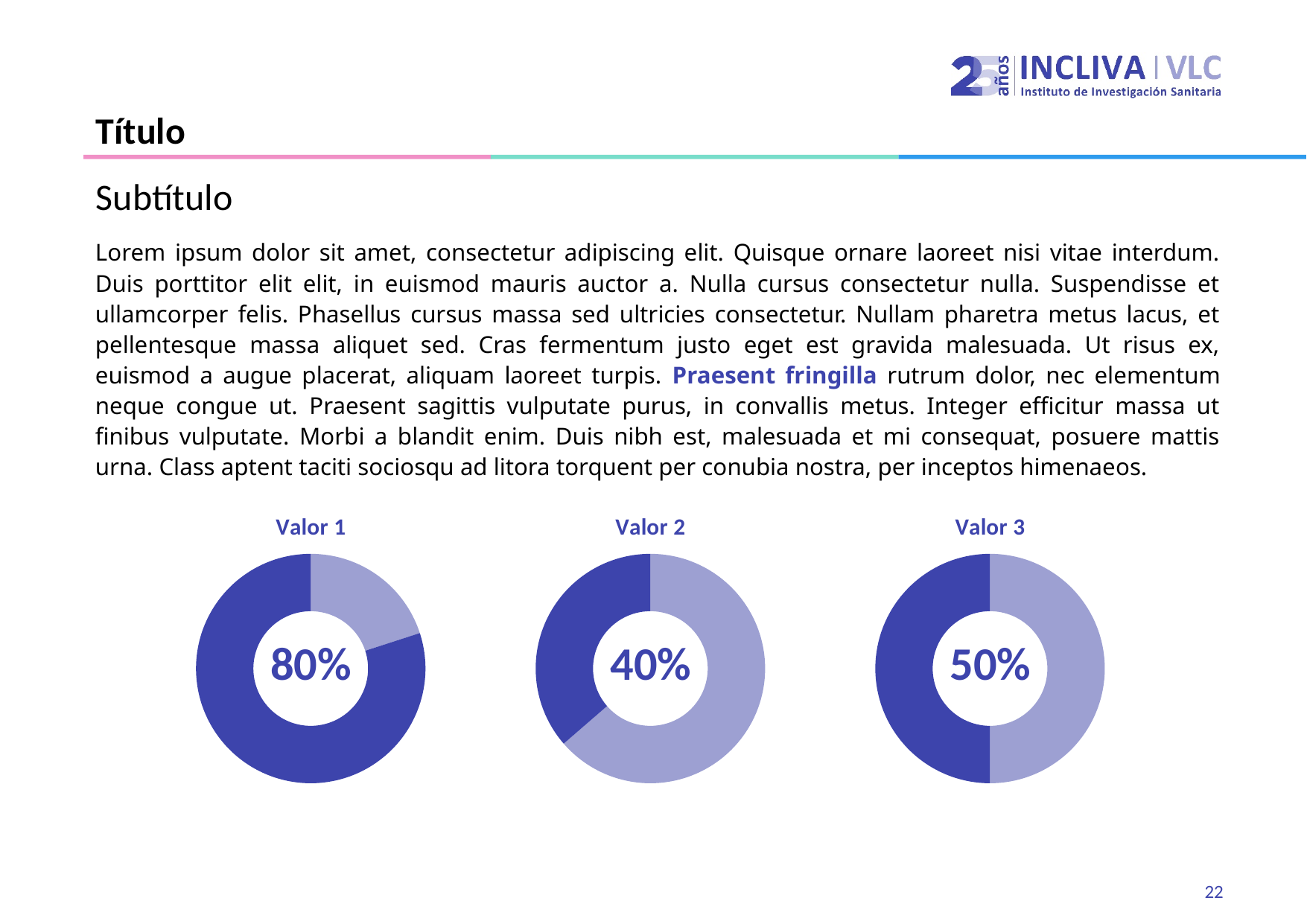
What is the difference between the percentage shown for Valor 1 and the percentage shown for Valor 2? 40% Which of the three charts (Valor 1, Valor 2, Valor 3) shows the highest percentage? Valor 1 What kind of chart is used for Valor 1? Donut chart Which shows a larger percentage, the Valor 2 chart or the Valor 3 chart? Valor 3 What value is shown in the centre of the Valor 1 chart? 80% What value is shown in the centre of the Valor 3 chart? 50% Which of the three charts (Valor 1, Valor 2, Valor 3) shows the lowest percentage? Valor 2 In the Valor 3 chart, what share of the ring is filled by the dark blue segment? 50% What value is shown in the centre of the Valor 2 chart? 40% Is the value shown in the Valor 2 chart greater or less than 50%? less How many donut charts are shown on the slide? 3 What is the difference between the percentage shown for Valor 3 and the percentage shown for Valor 2? 10%